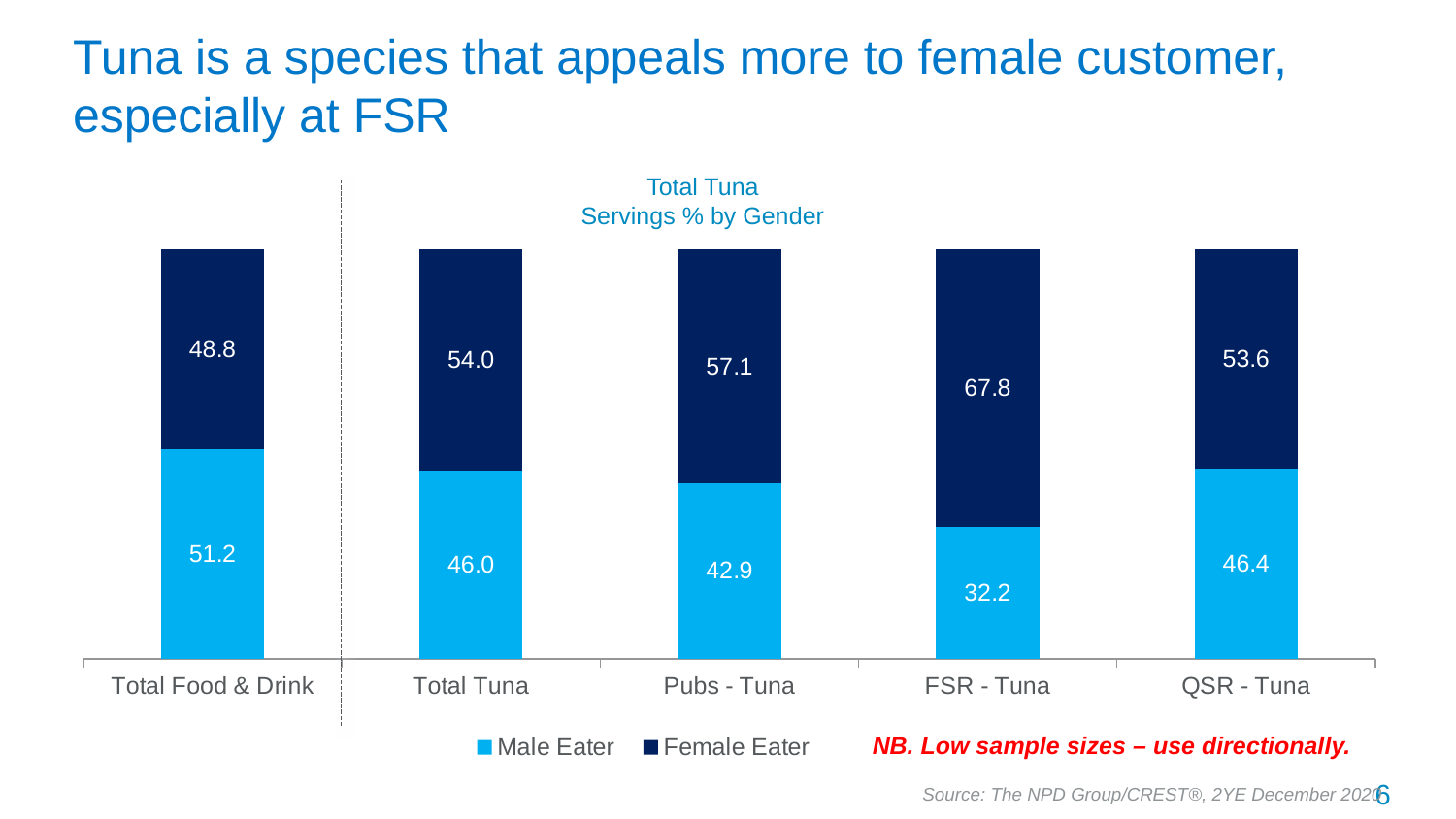
Which is larger for QSR - Tuna, the Male Eater value or the Female Eater value? Female Eater What is the difference between the Female Eater and Male Eater values for FSR - Tuna? 35.6 What is the Male Eater value for Total Food & Drink? 51.2 Which category has the highest Female Eater value? FSR - Tuna How many categories are shown on the x axis? 5 What is the Female Eater value for Pubs - Tuna? 57.1 What is the title of the chart? Total Tuna Servings % by Gender What is the total of the stacked bar for Total Tuna? 100.0 What kind of chart is shown on the slide? Stacked bar chart Which category has the lowest Male Eater value? FSR - Tuna What is the Male Eater value for FSR - Tuna? 32.2 How many series does the legend list? 2